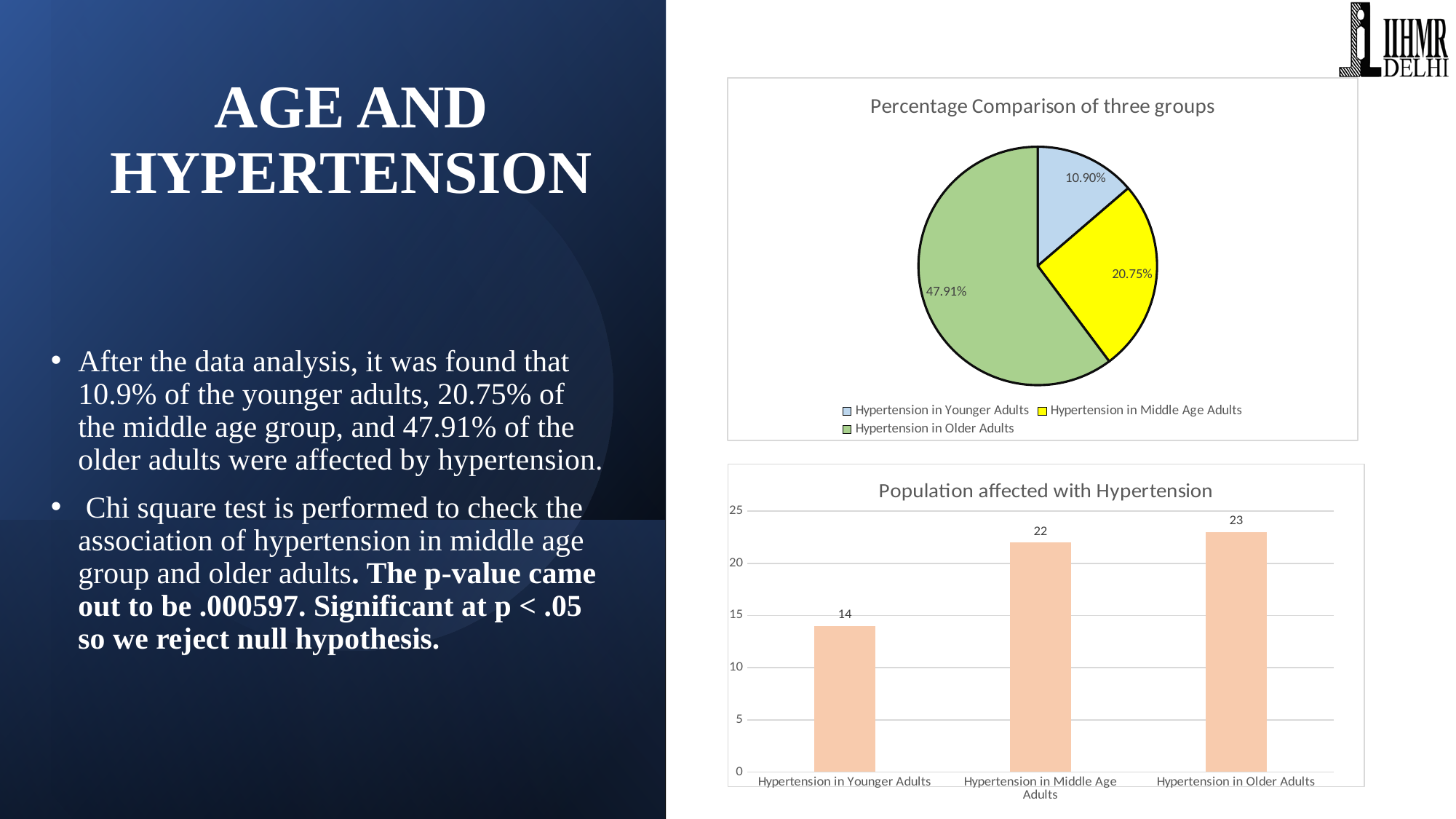
In the 'Population affected with Hypertension' chart, how many categories are shown on the x axis? 3 In the 'Population affected with Hypertension' chart, what is the difference between the values for Older Adults and Younger Adults? 9 How many entries does the legend of the 'Percentage Comparison of three groups' chart list? 3 What kind of chart is 'Percentage Comparison of three groups'? Pie chart In the 'Population affected with Hypertension' chart, which category has the highest value? Hypertension in Older Adults In the 'Percentage Comparison of three groups' chart, what percentage is shown for Hypertension in Older Adults? 47.91% What kind of chart is 'Population affected with Hypertension'? Bar chart In the 'Percentage Comparison of three groups' chart, which group has the smallest slice? Hypertension in Younger Adults In the 'Population affected with Hypertension' chart, what is the value for Hypertension in Younger Adults? 14 In the 'Percentage Comparison of three groups' chart, what percentage is shown for Hypertension in Younger Adults? 10.90% In the 'Population affected with Hypertension' chart, what is the value for Hypertension in Middle Age Adults? 22 In the 'Percentage Comparison of three groups' chart, which group has the largest slice? Hypertension in Older Adults